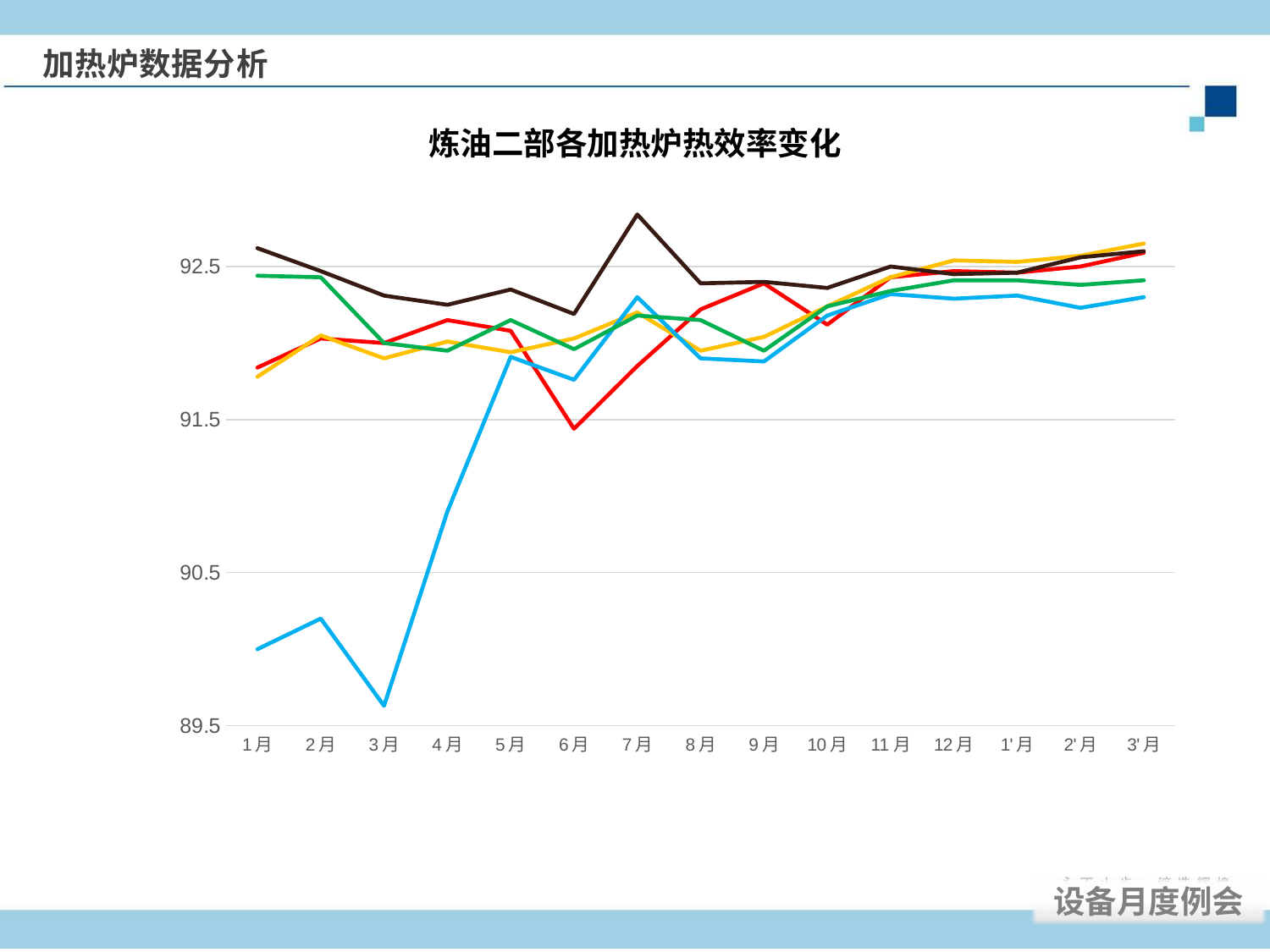
What kind of chart is shown on the slide? line chart At 6月, which is higher, the red line or the green line? the green line Which line has the highest value at 7月? the dark brown line What is the title of the chart? 炼油二部各加热炉热效率变化 How many lines are plotted on the chart? 5 Does the blue line rise or fall from 3月 to 5月? rise How many months (categories) are shown along the x axis? 15 In which month does the blue line reach its lowest value? 3月 Is the value of the blue line at 1月 greater or less than 90.5? less Is the value of the dark brown line at 7月 greater or less than 92.5? greater Which line has the lowest value at 3月? the blue line Is the value of the blue line at 3月 greater or less than 90.5? less